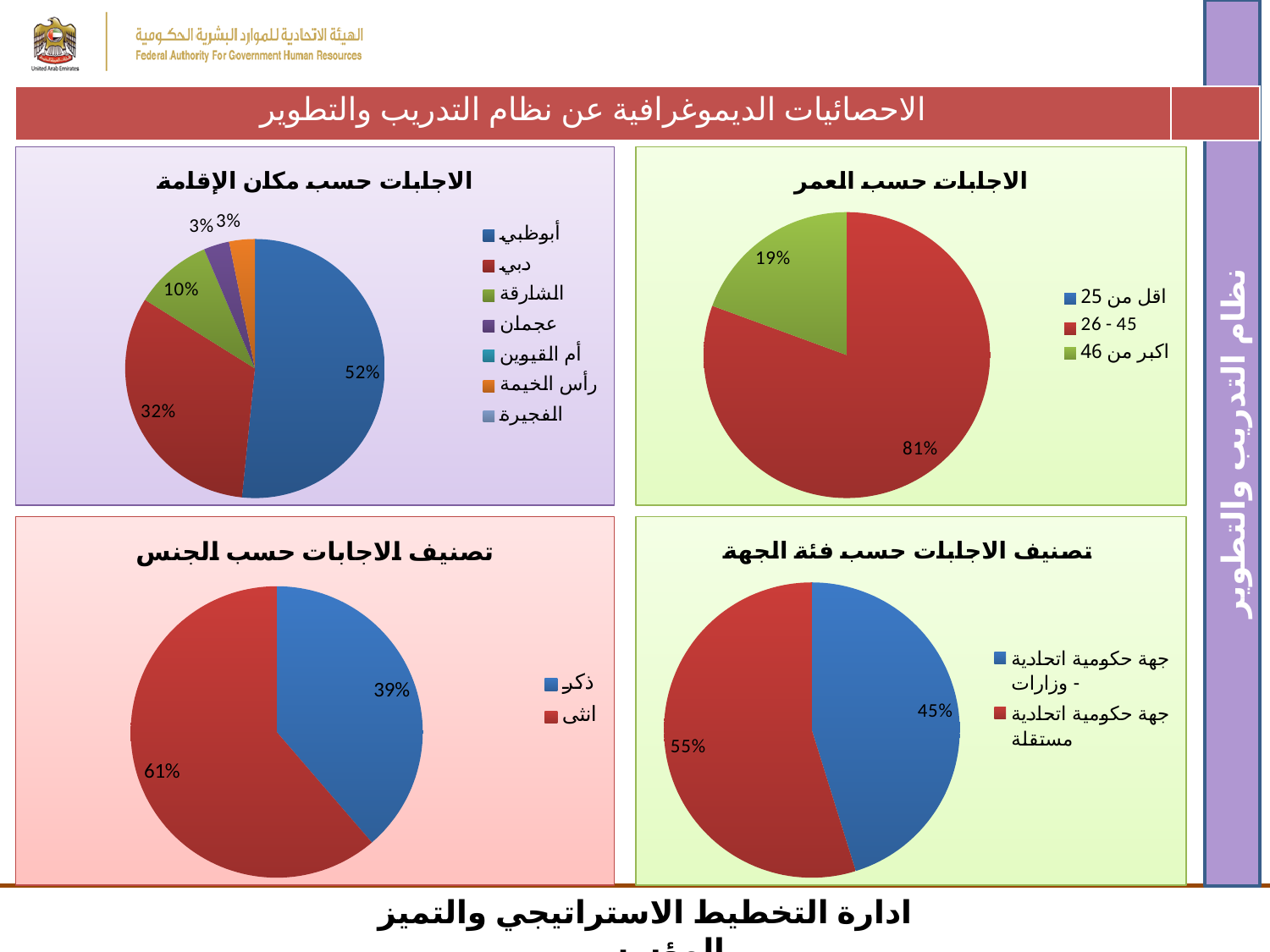
In the bottom-left chart (تصنيف الاجابات حسب الجنس), what percentage of respondents are انثى? 61% What type of chart is used in the bottom-right chart (تصنيف الاجابات حسب فئة الجهة)? Pie chart In the top-right chart (الاجابات حسب العمر), which age group has the largest share? 26 - 45 In the top-right chart (الاجابات حسب العمر), what percentage of respondents are in the 26 - 45 age group? 81% In the top-right chart (الاجابات حسب العمر), what percentage of respondents are اكبر من 46? 19% In the top-left chart (الاجابات حسب مكان الإقامة), what percentage of responses came from أبوظبي? 52% In the top-left chart (الاجابات حسب مكان الإقامة), what percentage of responses came from دبي? 32% In the top-left chart (الاجابات حسب مكان الإقامة), what is the difference between the shares for أبوظبي and دبي? 20% In the bottom-right chart (تصنيف الاجابات حسب فئة الجهة), what percentage of responses came from جهة حكومية اتحادية مستقلة? 55% In the top-left chart (الاجابات حسب مكان الإقامة), which place of residence has the largest share? أبوظبي In the bottom-left chart (تصنيف الاجابات حسب الجنس), which is larger, the share for ذكر or the share for انثى? انثى How many entries does the legend of the top-left chart (الاجابات حسب مكان الإقامة) list? 7